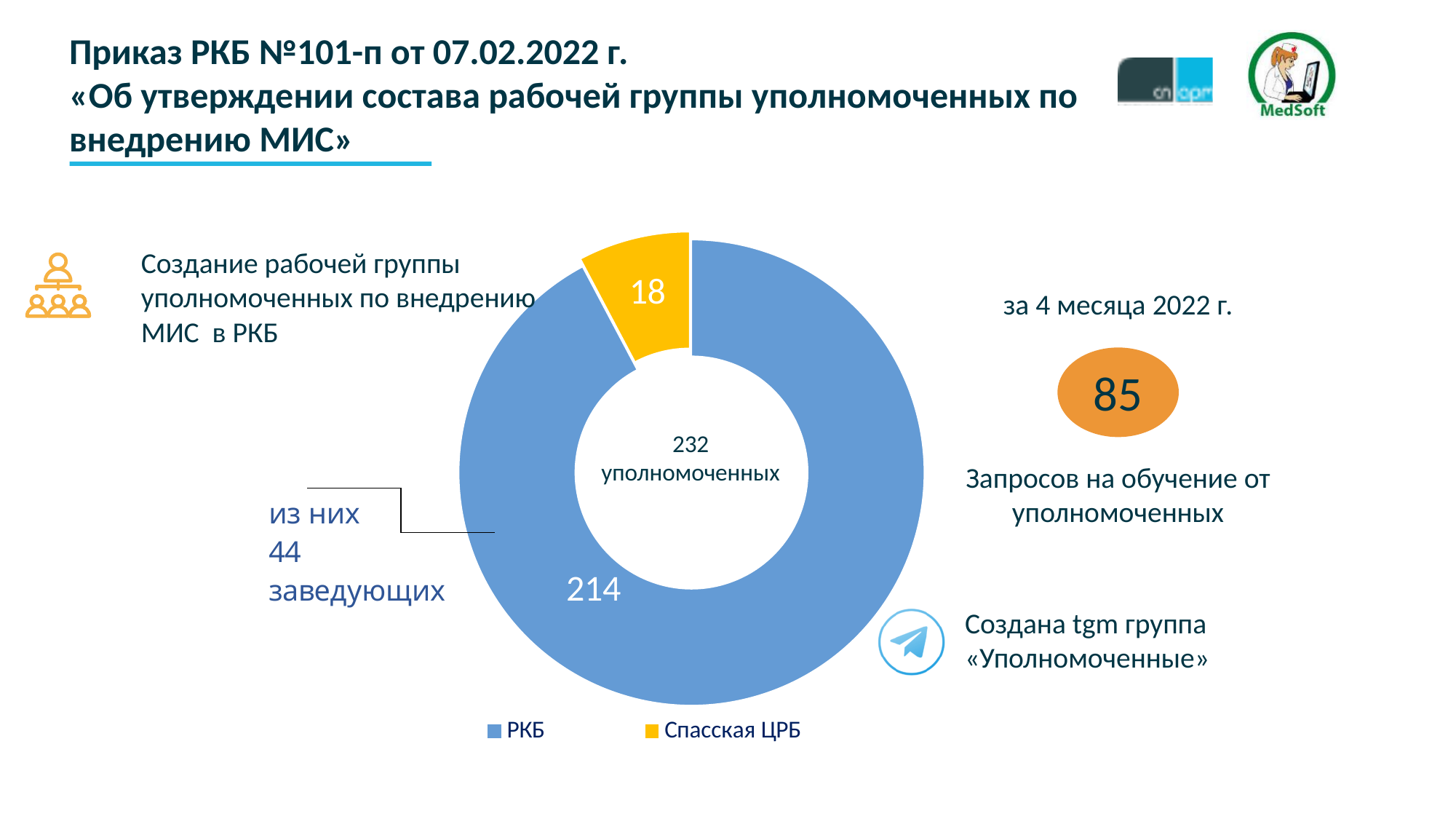
Which category has the largest slice in the doughnut chart? РКБ What total is printed in the centre of the doughnut chart? 232 уполномоченных What kind of chart is shown on the slide? Doughnut (pie) chart What value is shown for the Спасская ЦРБ slice of the doughnut chart? 18 What colour represents РКБ in the chart legend? Blue What is the difference between the РКБ value and the Спасская ЦРБ value in the chart? 196 How many categories does the doughnut chart show? 2 How many entries does the chart legend list? 2 What colour represents Спасская ЦРБ in the chart legend? Yellow Which category has the smallest slice in the doughnut chart? Спасская ЦРБ Which is larger in the chart: the value for РКБ or the value for Спасская ЦРБ? РКБ What value is shown for the РКБ slice of the doughnut chart? 214